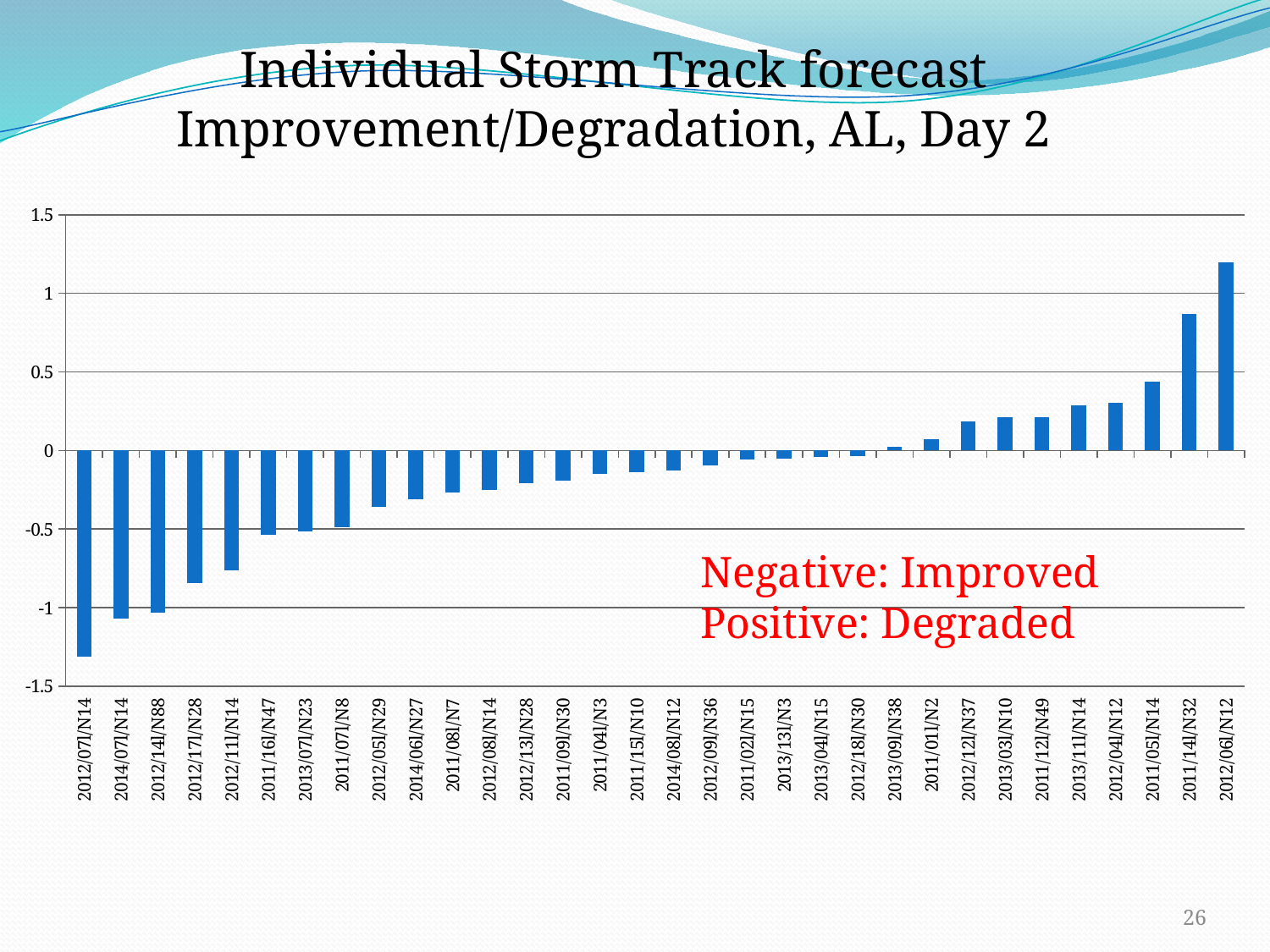
Do the bar values generally rise or fall from left to right along the x axis? rise Is the value for 2011/14/N32 greater or less than 0.5? greater Is the value for 2012/17/N28 greater or less than -0.5? less Which storm case has the highest (most positive) value? 2012/06l/N12 Is the value for 2012/06/N12 greater or less than 1? greater Which storm case has the lowest (most negative) value? 2012/07l/N14 How many bars (storm cases) are plotted in the chart? 32 According to the annotation on the chart, what does a negative value indicate? Improved Which has the larger value, 2011/14/N32 or 2012/06/N12? 2012/06l/N12 What kind of chart is shown on the slide? bar chart